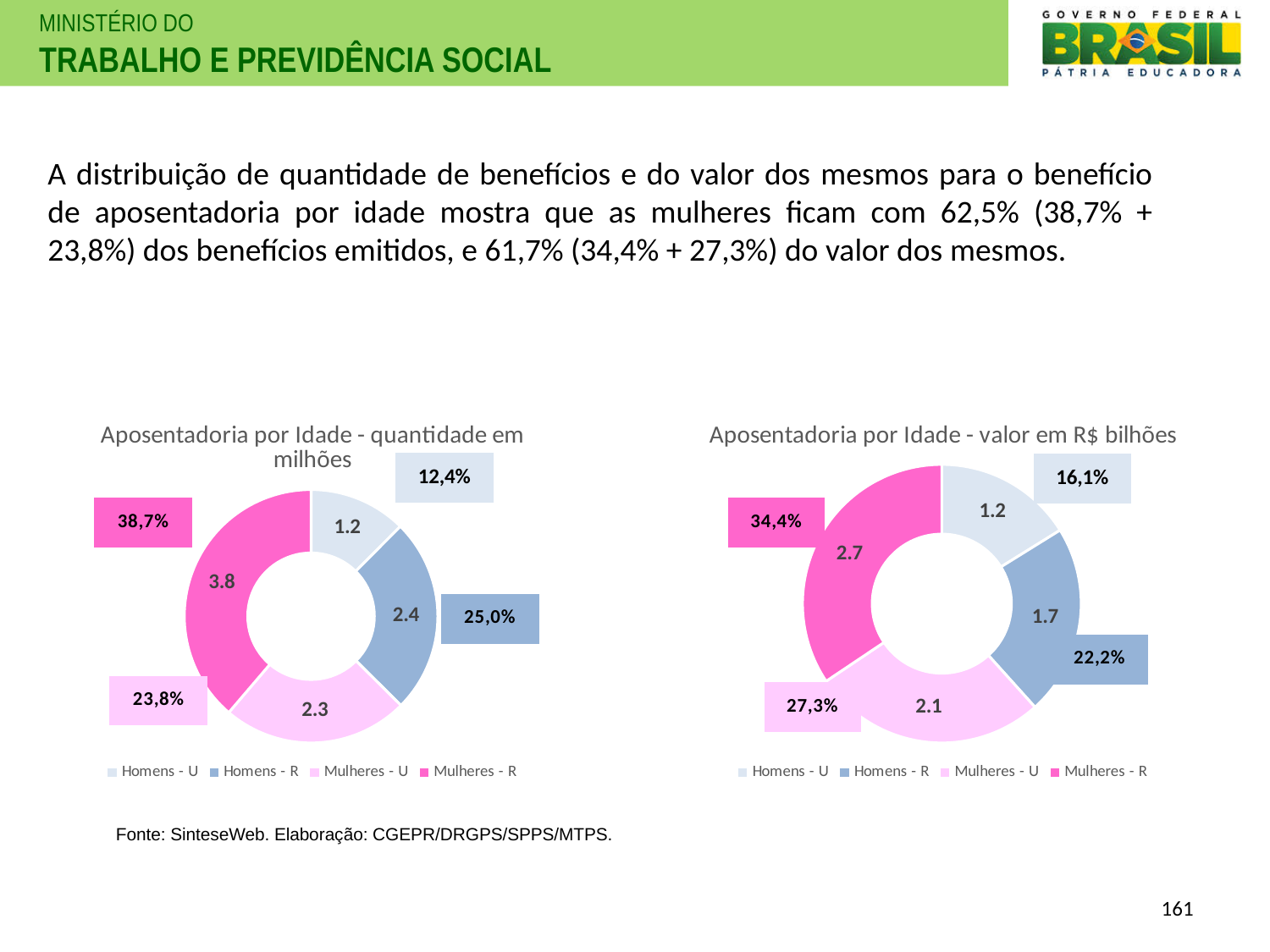
How many categories does the legend of the chart titled 'Aposentadoria por Idade - valor em R$ bilhões' list? 4 In the chart titled 'Aposentadoria por Idade - valor em R$ bilhões', what is the difference between the values for Mulheres - R and Homens - R? 1.0 In the chart titled 'Aposentadoria por Idade - quantidade em milhões', what percentage share is shown for Homens - R? 25,0% In the chart titled 'Aposentadoria por Idade - quantidade em milhões', what is the value for Mulheres - R? 3.8 In the chart titled 'Aposentadoria por Idade - valor em R$ bilhões', what is the value for Mulheres - U? 2.1 In the chart titled 'Aposentadoria por Idade - valor em R$ bilhões', which is larger, the value for Homens - R or the value for Mulheres - U? Mulheres - U In the chart titled 'Aposentadoria por Idade - quantidade em milhões', which category has the smallest value? Homens - U What kind of chart is the chart titled 'Aposentadoria por Idade - quantidade em milhões'? Doughnut (pie) chart In the chart titled 'Aposentadoria por Idade - quantidade em milhões', what percentage share is shown for Homens - U? 12,4% In the chart titled 'Aposentadoria por Idade - quantidade em milhões', what is the difference between the values for Mulheres - R and Homens - U? 2.6 In the chart titled 'Aposentadoria por Idade - quantidade em milhões', which category has the largest value? Mulheres - R In the chart titled 'Aposentadoria por Idade - valor em R$ bilhões', what percentage share is shown for Mulheres - R? 34,4%